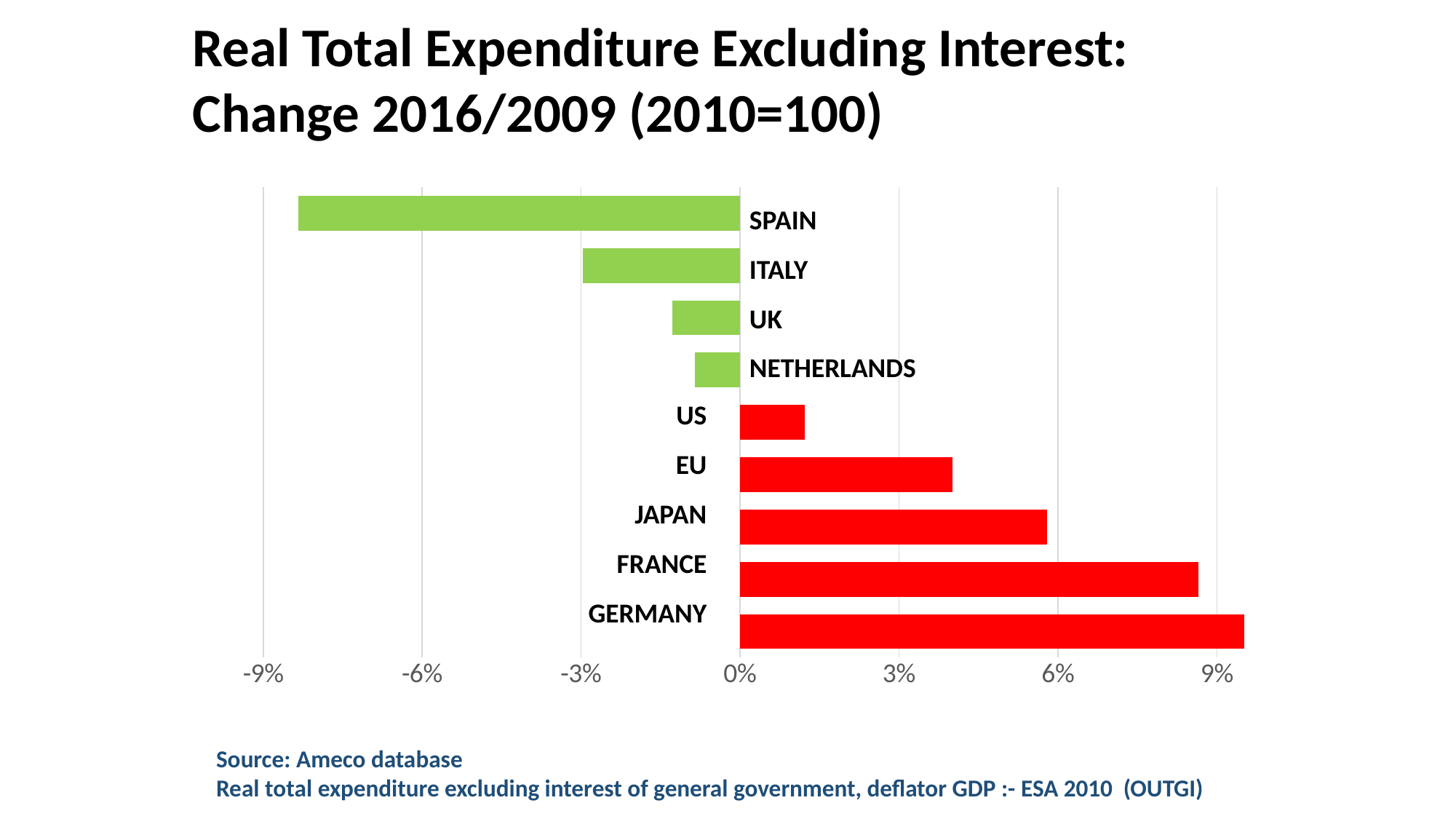
What colour are the bars for countries with negative values? green Is the value for UK greater or less than -3%? greater How many countries or regions are shown in the chart? 9 Is the value for Germany greater or less than 9%? greater Is the value for EU greater or less than 3%? greater Which country or region has the lowest change in real total expenditure excluding interest? Spain Which has the larger value, France or Japan? France What kind of chart is shown on the slide? bar chart Which country or region has the highest change in real total expenditure excluding interest? Germany